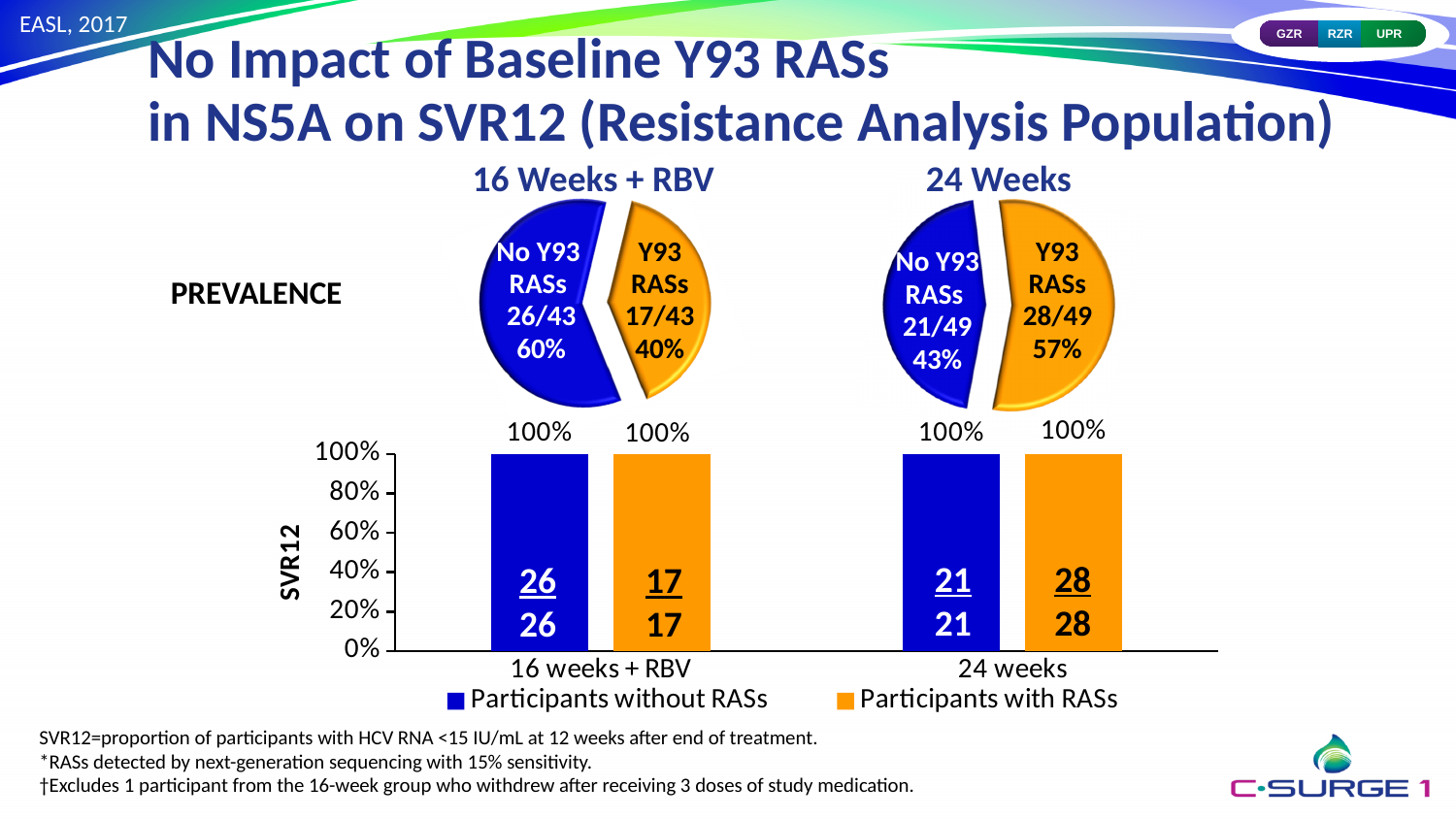
In the SVR12 bar chart, what is the SVR12 value for participants without RASs in the 16 weeks + RBV group? 100% In the 24 Weeks prevalence pie chart, what share of participants had no Y93 RASs? 43% What kind of chart is the SVR12 chart at the bottom of the slide? Bar chart In the SVR12 bar chart, what fraction is printed on the bar for participants with RASs in the 16 weeks + RBV group? 17/17 In the SVR12 bar chart, how many categories are shown on the x axis? 2 In the SVR12 bar chart, how many series does the legend list? 2 In the SVR12 bar chart, what fraction is printed on the bar for participants without RASs in the 24 weeks group? 21/21 In the SVR12 bar chart, what is the label of the y axis? SVR12 In the 16 Weeks + RBV prevalence pie chart, what share of participants had Y93 RASs? 40% In the 16 Weeks + RBV prevalence pie chart, which slice is larger: No Y93 RASs or Y93 RASs? No Y93 RASs In the 24 Weeks prevalence pie chart, what fraction is shown for Y93 RASs? 28/49 In the SVR12 bar chart, what is the SVR12 value for participants with RASs in the 24 weeks group? 100%